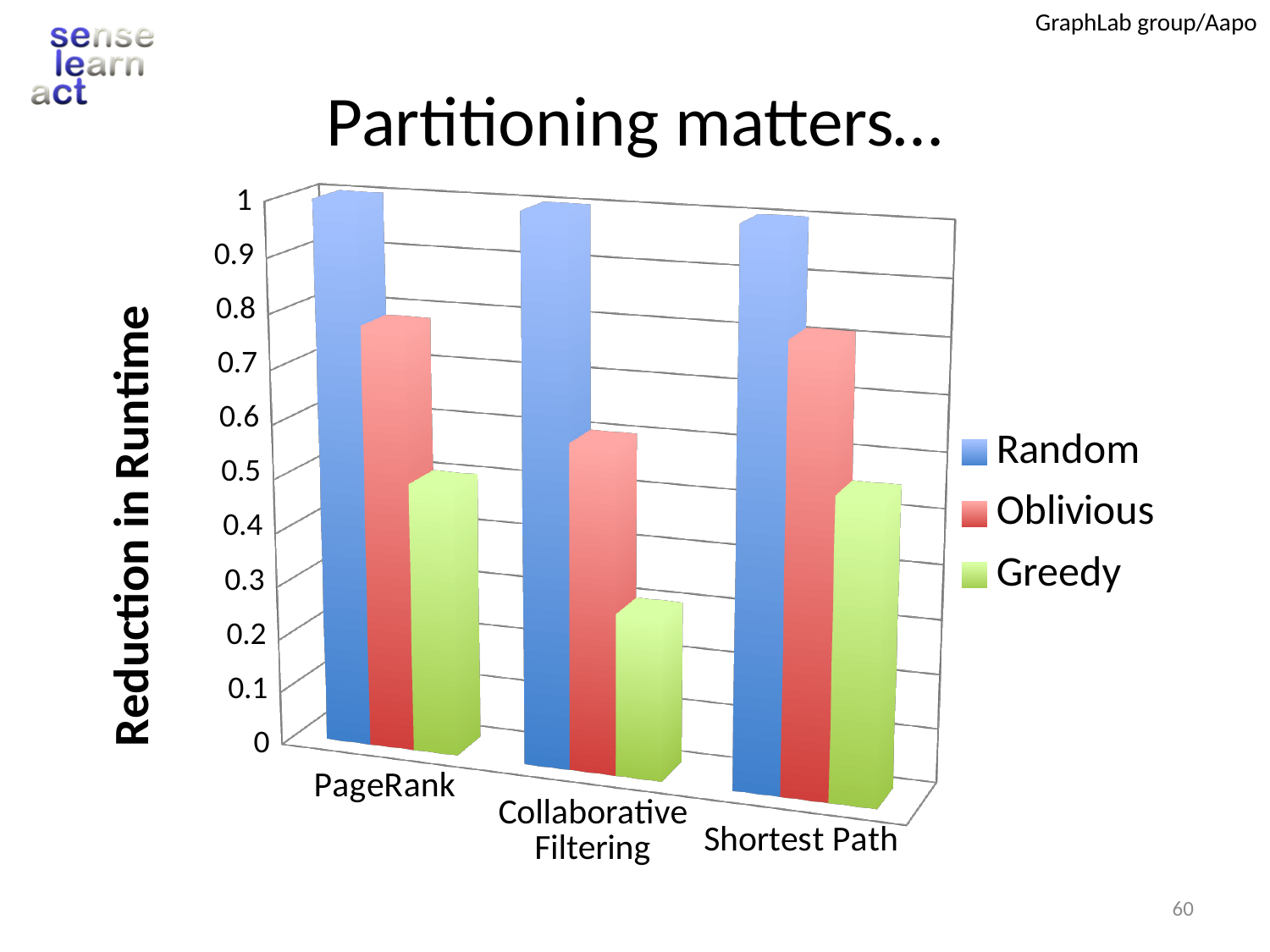
For Shortest Path, which is larger: the Random value or the Greedy value? Random Which series has the highest value for PageRank? Random What kind of chart is shown on the slide? Bar chart How many series does the chart's legend list? 3 For which category is the Greedy value lowest? Collaborative Filtering Is the Random value for PageRank greater or less than 0.8? greater For Collaborative Filtering, which is larger: the Oblivious value or the Greedy value? Oblivious Is the Greedy value for Collaborative Filtering greater or less than 0.4? less What is the title of the chart on the slide? Partitioning matters… Which series has the lowest value for Collaborative Filtering? Greedy What is the label on the vertical axis of the chart? Reduction in Runtime How many categories are shown on the x axis of the chart? 3